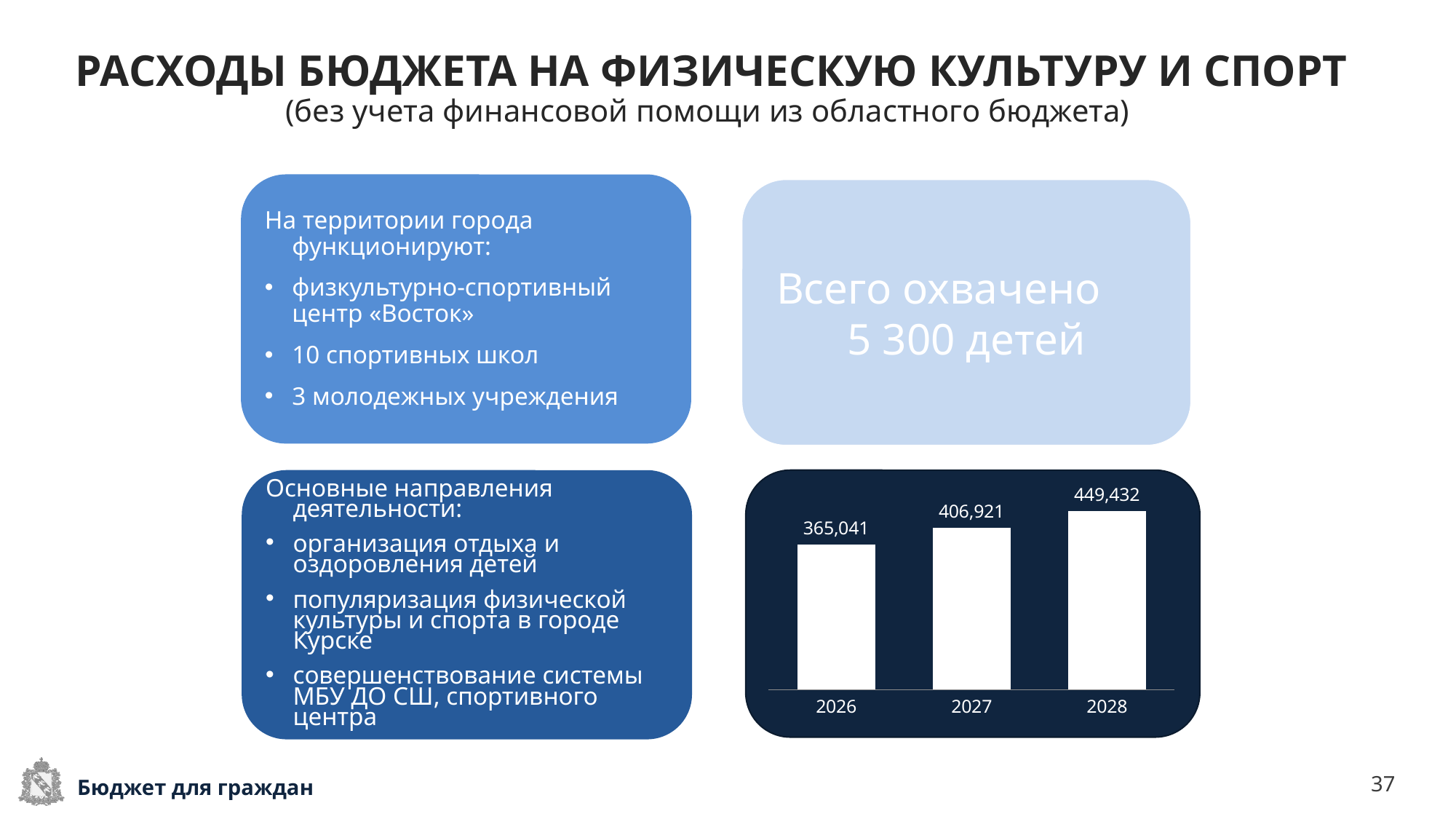
Which year has the lowest value in the bar chart? 2026 What is the difference between the values for 2028 and 2027 in the bar chart? 42,511 What is the value shown for 2026 in the bar chart? 365,041 What is the difference between the values for 2028 and 2026 in the bar chart? 84,391 Which year has the highest value in the bar chart? 2028 Which is larger in the bar chart, the value for 2026 or the value for 2028? 2028 What is the difference between the values for 2027 and 2026 in the bar chart? 41,880 How many bars are shown in the bar chart? 3 What is the value shown for 2027 in the bar chart? 406,921 What is the value shown for 2028 in the bar chart? 449,432 What type of chart is shown on the slide? bar chart Do the values in the bar chart rise or fall from 2026 to 2028? rise